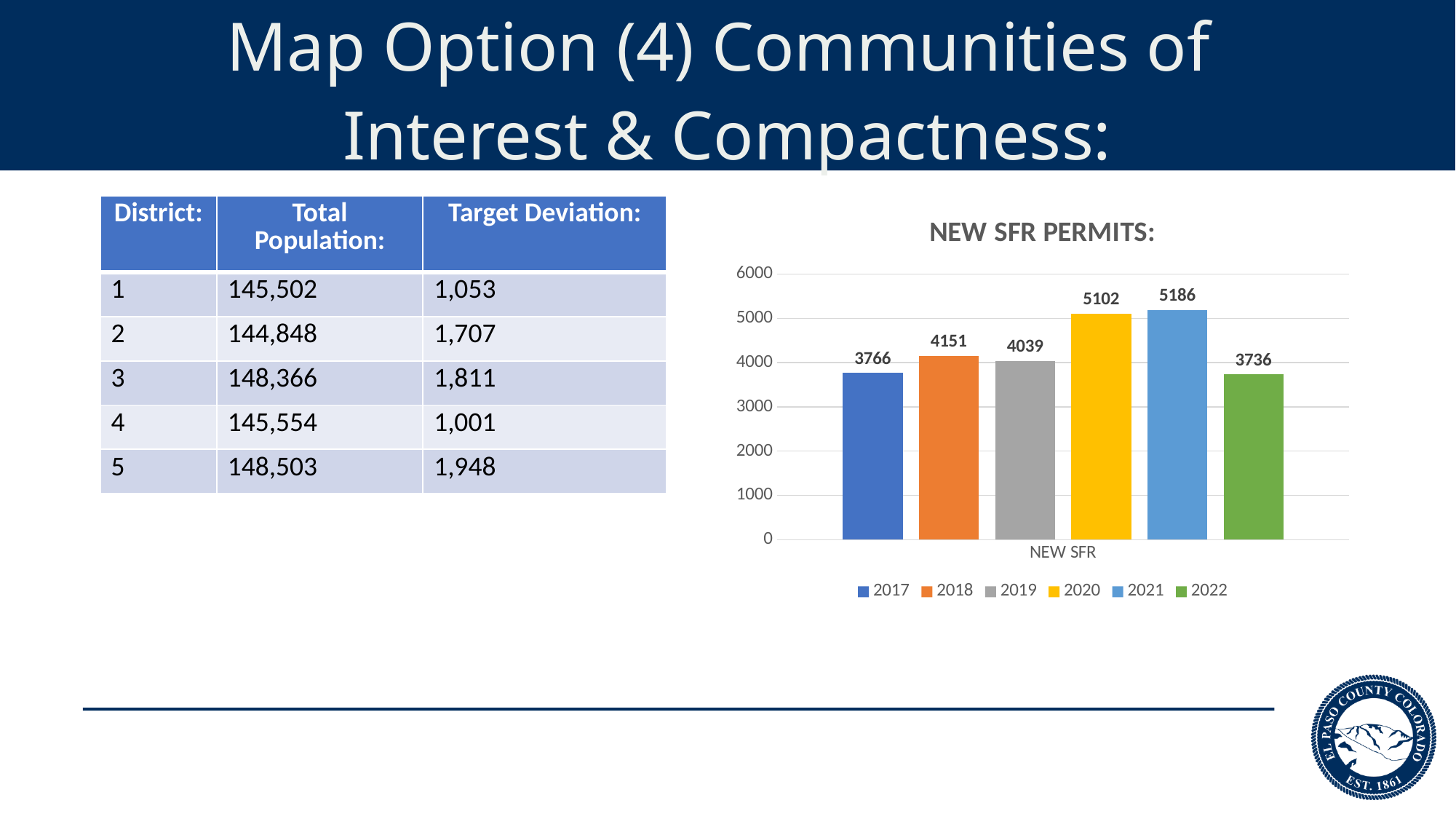
What is the value for 2020 in the NEW SFR PERMITS chart? 5102 In the NEW SFR PERMITS chart, which is larger, the value for 2018 or the value for 2022? 2018 Which year has the highest value in the NEW SFR PERMITS chart? 2021 Which year has the lowest value in the NEW SFR PERMITS chart? 2022 What is the value for 2017 in the NEW SFR PERMITS chart? 3766 What is the value for 2022 in the NEW SFR PERMITS chart? 3736 What is the difference between the 2018 and 2019 values in the NEW SFR PERMITS chart? 112 What is the title of the chart on the slide? NEW SFR PERMITS: What kind of chart is the NEW SFR PERMITS chart? bar chart What is the difference between the 2021 and 2020 values in the NEW SFR PERMITS chart? 84 Is the value for 2019 in the NEW SFR PERMITS chart greater or less than 3000? greater How many series does the legend of the NEW SFR PERMITS chart list? 6